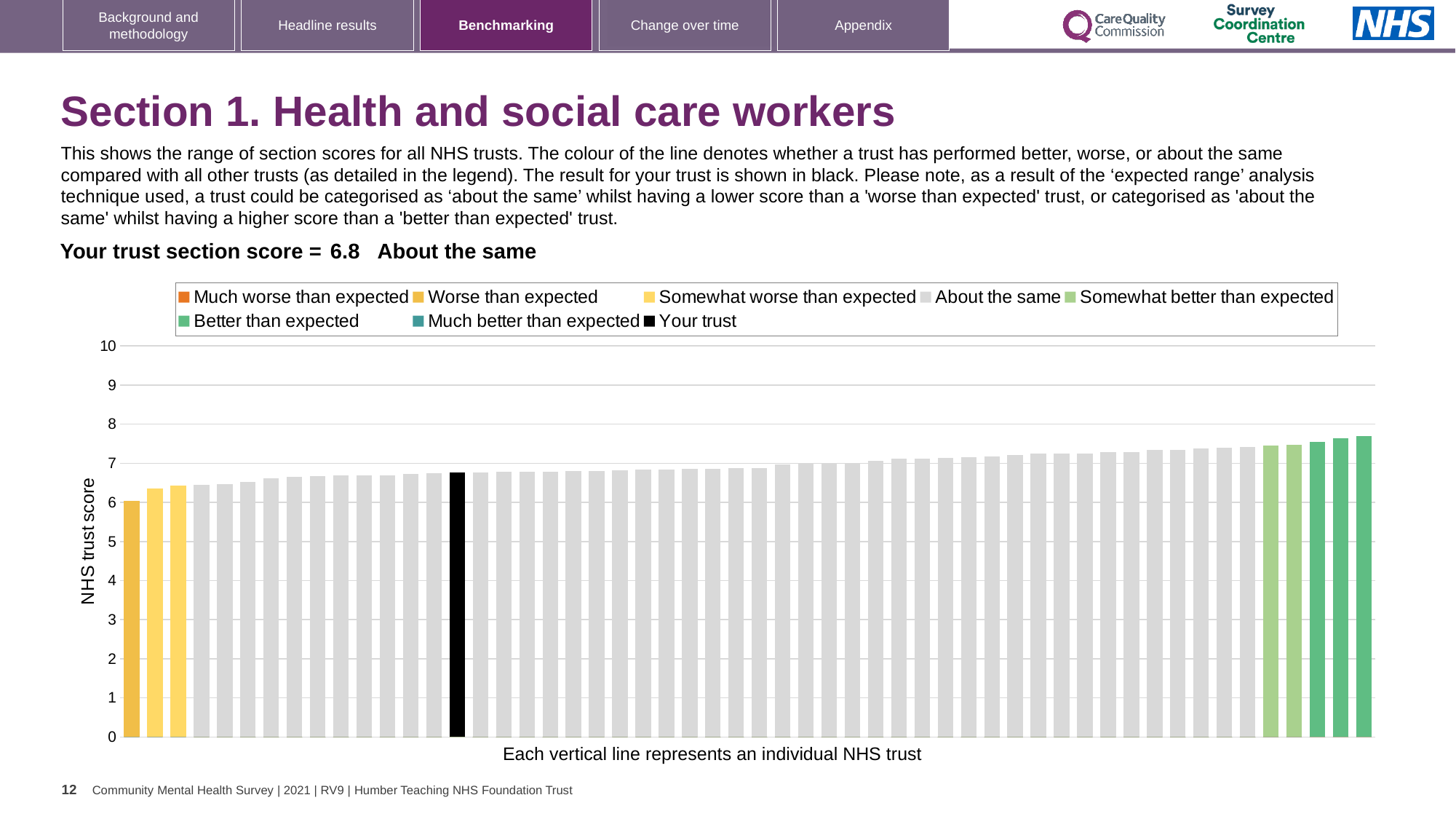
Do the bar values rise or fall from left to right along the x axis? Rise Which legend category does the shortest bar in the chart belong to? Worse than expected How many bars are coloured as 'Somewhat worse than expected' (yellow)? 2 Is the value of the shortest bar in the chart greater or less than 5? greater Is the value of the black 'Your trust' bar greater or less than 5? greater What colour is used for the 'Your trust' bar? Black How is the trust's section score categorised relative to other trusts? About the same What kind of chart is shown on the slide? Bar chart What is the trust's section score for Section 1, Health and social care workers? 6.8 How many entries does the chart legend list? 8 What is the label of the vertical axis? NHS trust score Is the value of the tallest bar in the chart greater or less than 8? less